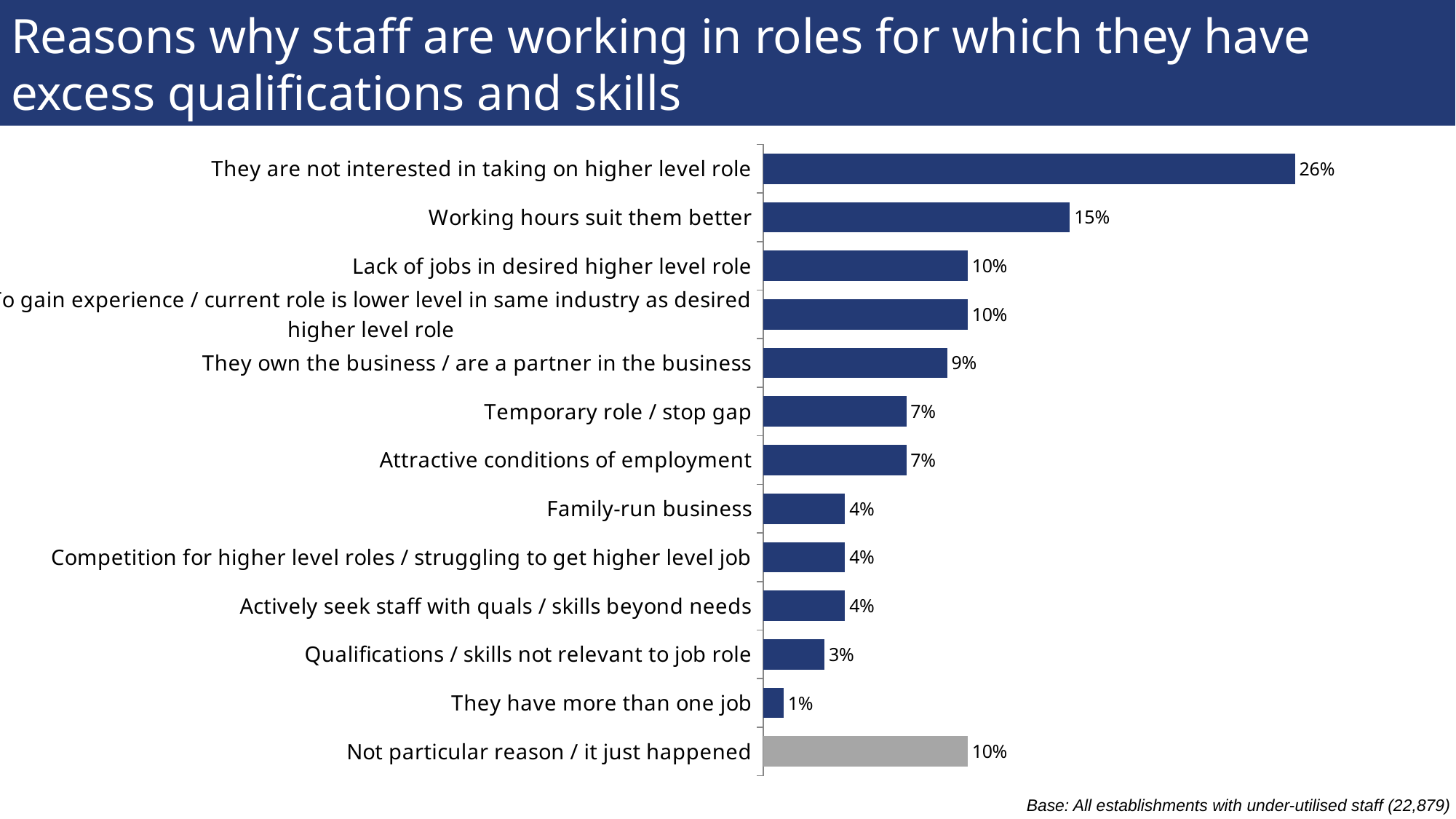
What is the difference between 'They are not interested in taking on higher level role' and 'Working hours suit them better'? 11% Which bar is shown in a different colour (grey) from the others? Not particular reason / it just happened What percentage is shown for 'They own the business / are a partner in the business'? 9% Which reason has the highest percentage? They are not interested in taking on higher level role What is the value for 'Qualifications / skills not relevant to job role'? 3% Which reason has the lowest percentage? They have more than one job What is the value for 'Working hours suit them better'? 15% What percentage is shown for 'They are not interested in taking on higher level role'? 26% What kind of chart is shown on the slide? Bar chart What is the value for 'Not particular reason / it just happened'? 10% Which is larger: 'Temporary role / stop gap' or 'Family-run business'? Temporary role / stop gap How many reasons (bars) are shown in the chart? 13